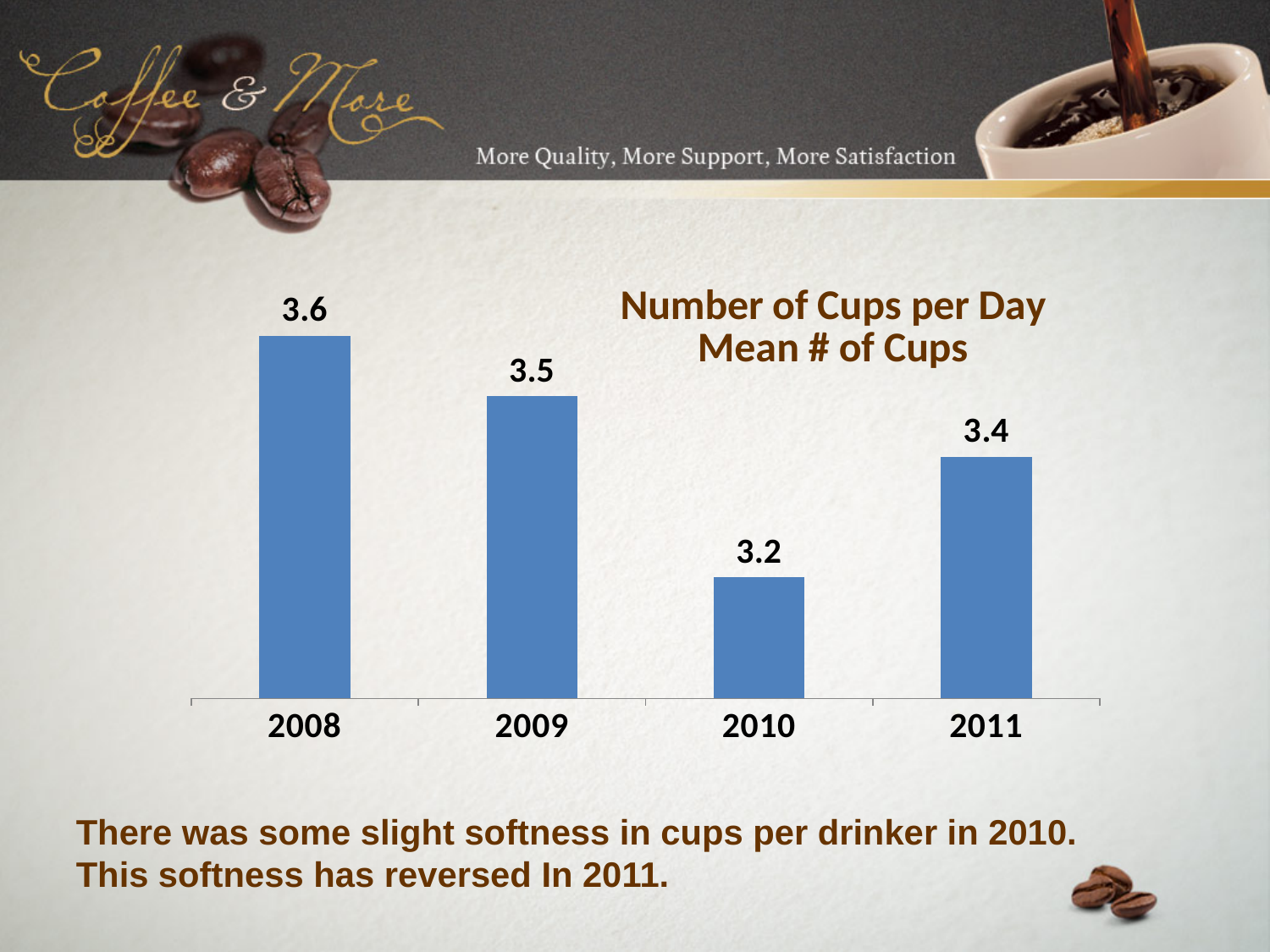
What kind of chart is shown on the slide? Bar chart What is the mean number of cups per day in 2010? 3.2 Which year has a higher mean number of cups per day, 2009 or 2011? 2009 What is the mean number of cups per day in 2011? 3.4 Which year has the highest mean number of cups per day? 2008 What is the difference between the mean number of cups in 2011 and 2010? 0.2 What is the difference between the mean number of cups in 2008 and 2010? 0.4 Does the mean number of cups per day rise or fall from 2008 to 2010? Fall What is the title of the chart? Number of Cups per Day Mean # of Cups What is the mean number of cups per day in 2008? 3.6 Which year has the lowest mean number of cups per day? 2010 How many years are shown on the chart? 4